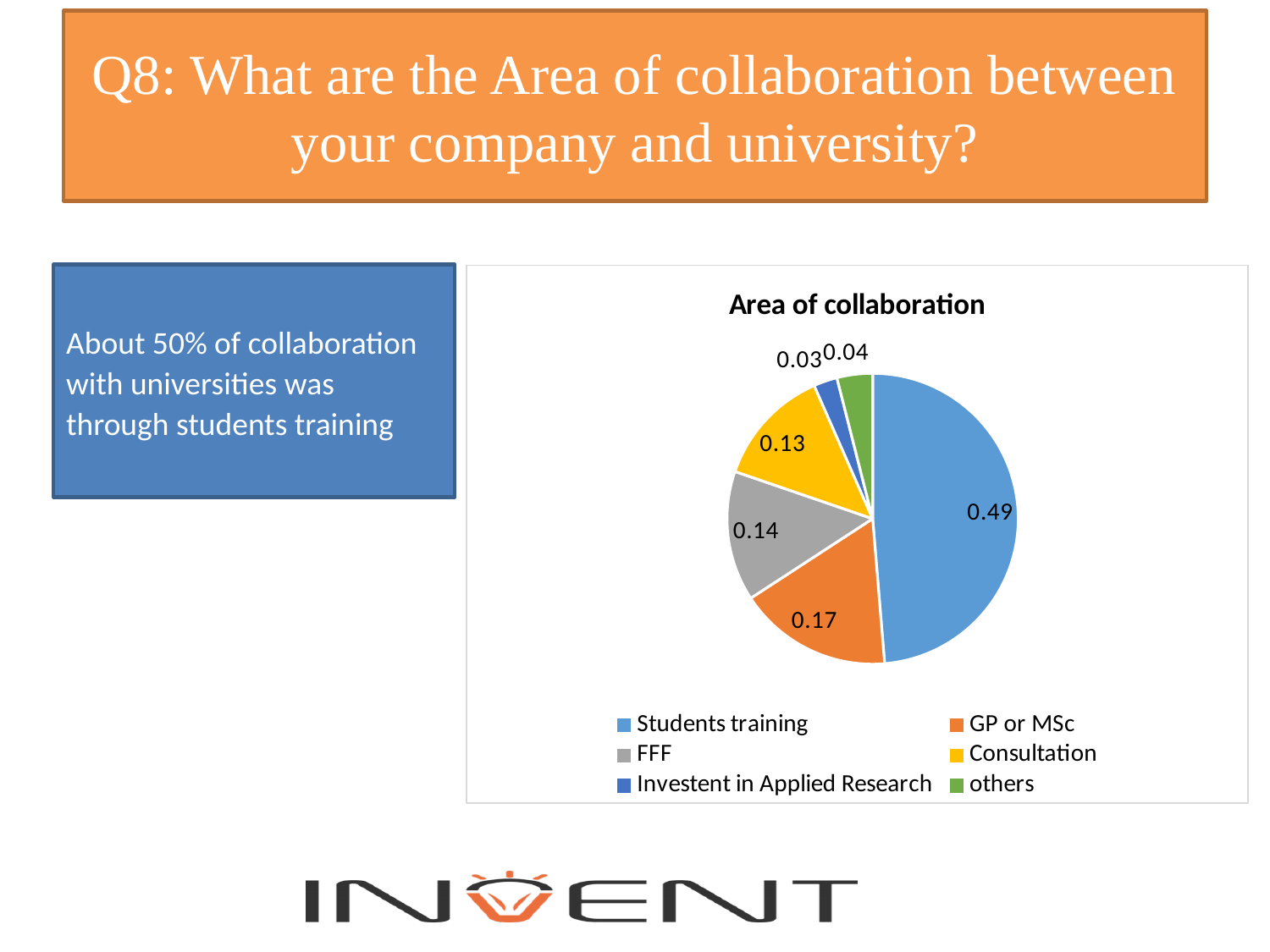
What is the value for others? 0.04 What is the value for Consultation? 0.13 What is the value for GP or MSc? 0.17 What is the difference between the values for Students training and GP or MSc? 0.32 Which category has the largest slice of the pie? Students training Which category has the smallest slice of the pie? Investent in Applied Research How many categories does the legend list? 6 Which is larger, the value for FFF or the value for Consultation? FFF What is the title of the chart? Area of collaboration What is the value for Students training? 0.49 What is the value for FFF? 0.14 What kind of chart is shown on the slide? pie chart